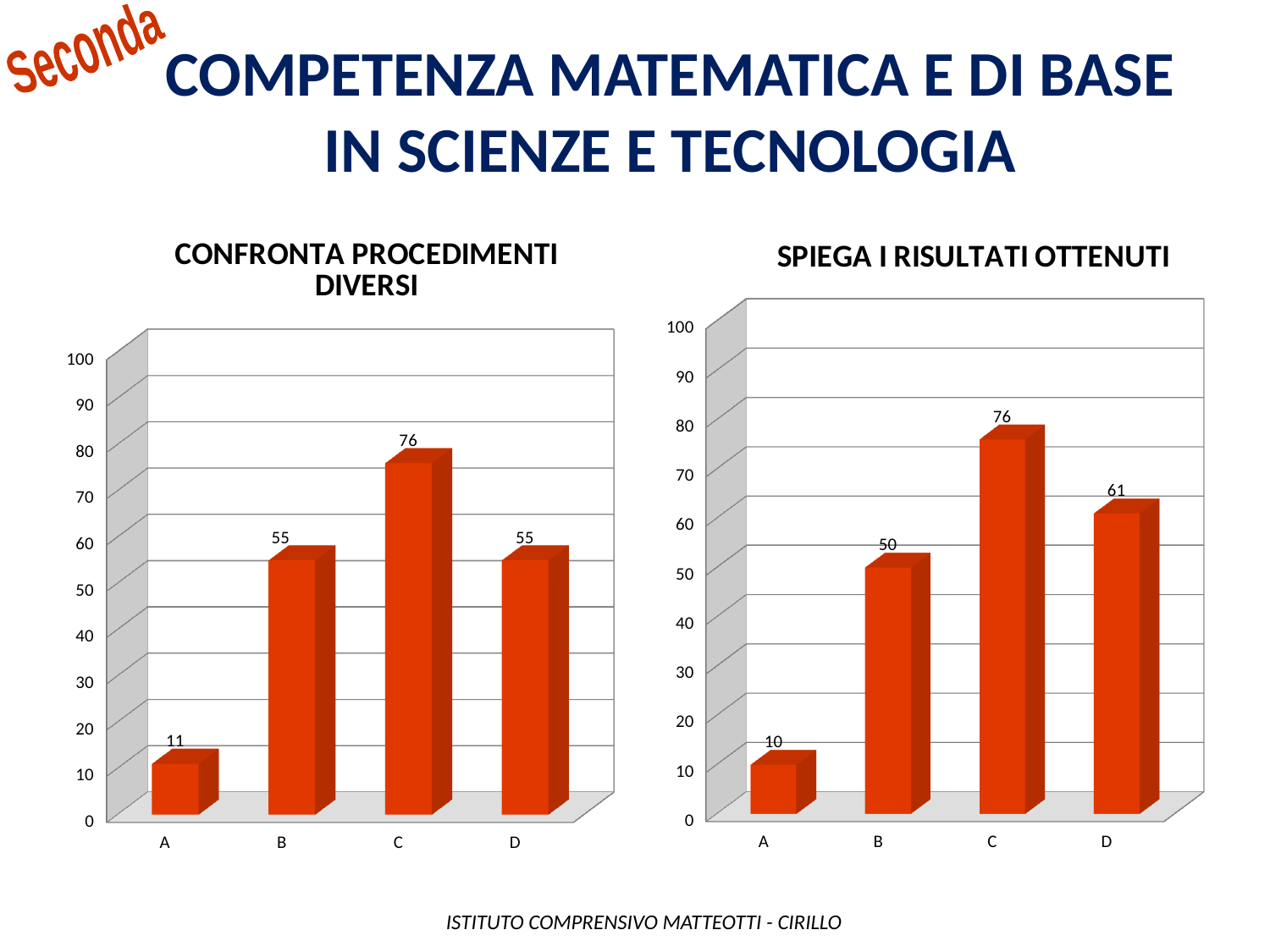
In the 'CONFRONTA PROCEDIMENTI DIVERSI' chart, what is the value for category C? 76 In the 'CONFRONTA PROCEDIMENTI DIVERSI' chart, which category has the highest value? C In the 'CONFRONTA PROCEDIMENTI DIVERSI' chart, what is the difference between the values for B and A? 44 In the 'SPIEGA I RISULTATI OTTENUTI' chart, which is larger, the value for B or the value for D? D In the 'SPIEGA I RISULTATI OTTENUTI' chart, what is the value for category B? 50 In the 'SPIEGA I RISULTATI OTTENUTI' chart, what is the value for category D? 61 In the 'CONFRONTA PROCEDIMENTI DIVERSI' chart, what is the value for category A? 11 How many categories are shown in the 'SPIEGA I RISULTATI OTTENUTI' chart? 4 In the 'CONFRONTA PROCEDIMENTI DIVERSI' chart, is the value for D greater or less than 50? greater In the 'SPIEGA I RISULTATI OTTENUTI' chart, what is the difference between the values for C and D? 15 In the 'SPIEGA I RISULTATI OTTENUTI' chart, which category has the lowest value? A What kind of chart is the 'CONFRONTA PROCEDIMENTI DIVERSI' chart? Bar chart